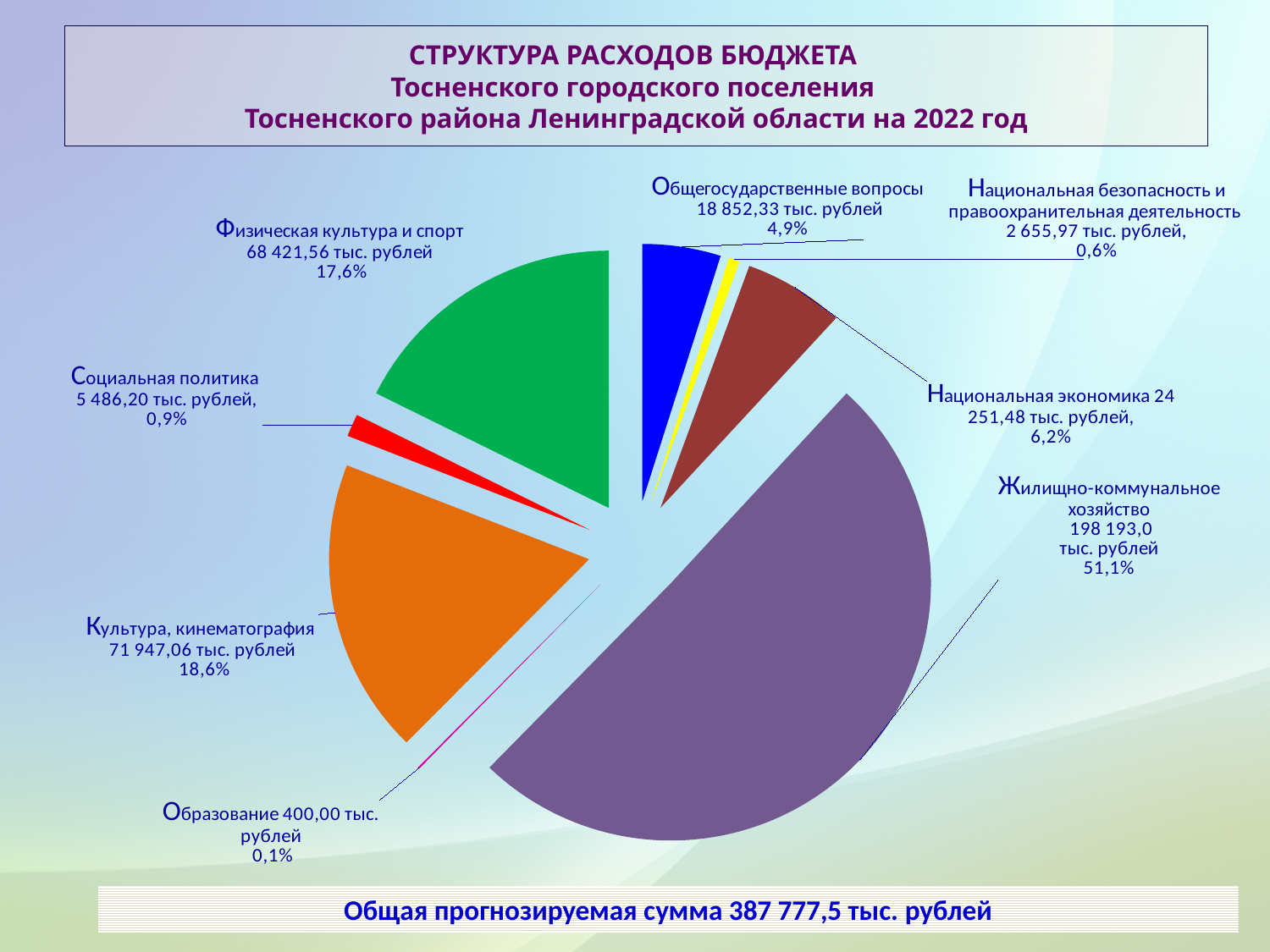
What is the value for Культура, кинематография? 71 947,06 тыс. рублей How many slices does the pie chart have? 8 What kind of chart is shown on the slide? Pie chart What share of the pie does Жилищно-коммунальное хозяйство take? 51,1% Which category has the smallest slice of the pie? Образование What percentage is shown for Физическая культура и спорт? 17,6% What total forecast sum is stated at the bottom of the slide? 387 777,5 тыс. рублей What is the difference in percentage points between Национальная экономика (6,2%) and Общегосударственные вопросы (4,9%)? 1,3 Which category has the largest slice of the pie? Жилищно-коммунальное хозяйство What is the value for Национальная безопасность и правоохранительная деятельность? 2 655,97 тыс. рублей Which is larger, Культура, кинематография or Физическая культура и спорт? Культура, кинематография What is the value for Жилищно-коммунальное хозяйство? 198 193,0 тыс. рублей